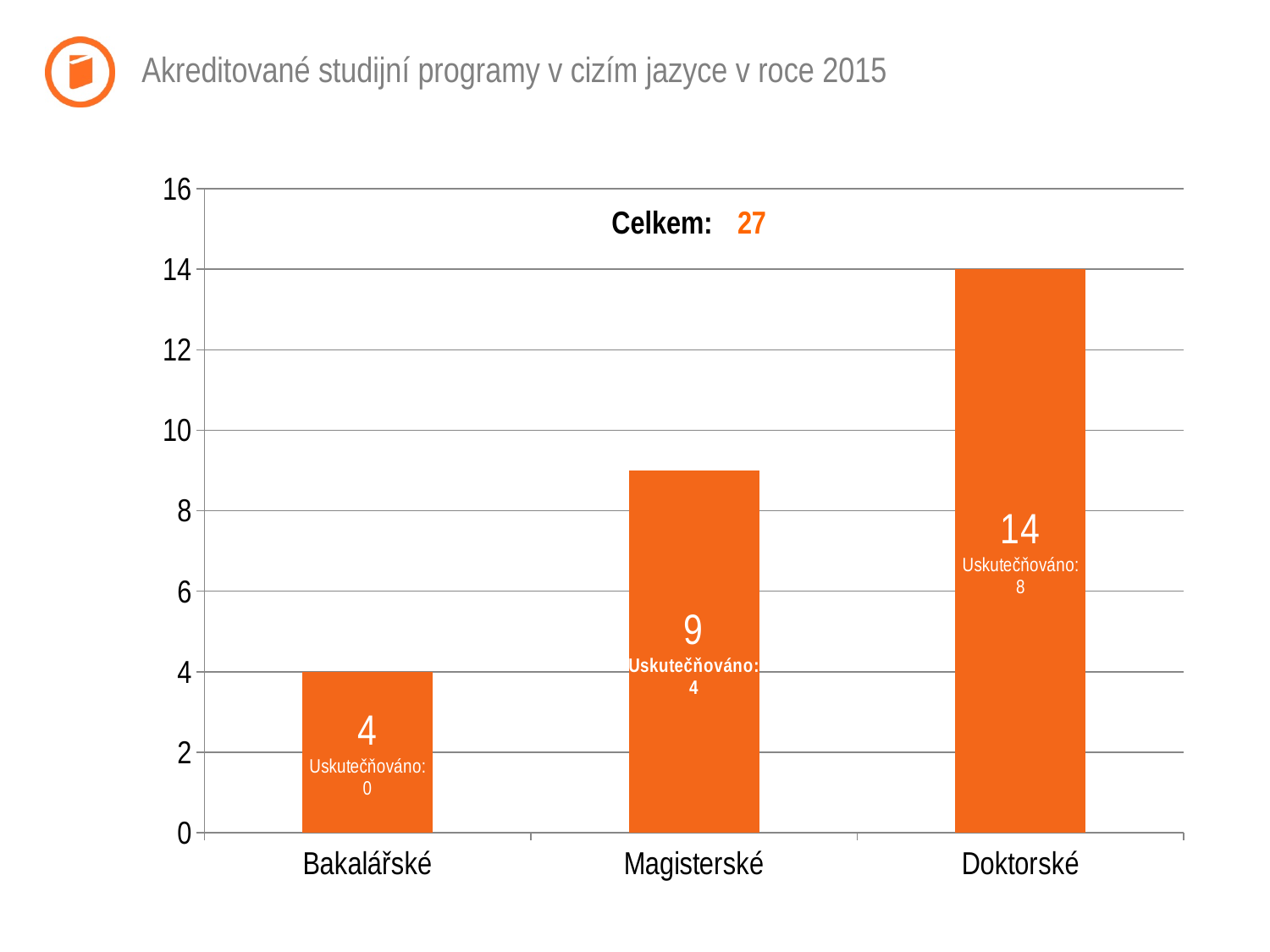
What is the difference between the values for Magisterské and Bakalářské? 5 Which is larger, the value for Magisterské or the value for Bakalářské? Magisterské Which category has the highest value? Doktorské What kind of chart is shown on the slide? bar chart How many categories are shown on the x axis? 3 What is the value for Bakalářské? 4 Do the values rise or fall from Bakalářské to Doktorské along the x axis? rise What is the value for Doktorské? 14 What is the value for Magisterské? 9 What total (Celkem) is printed on the chart? 27 Which category has the lowest value? Bakalářské What is the difference between the values for Doktorské and Magisterské? 5